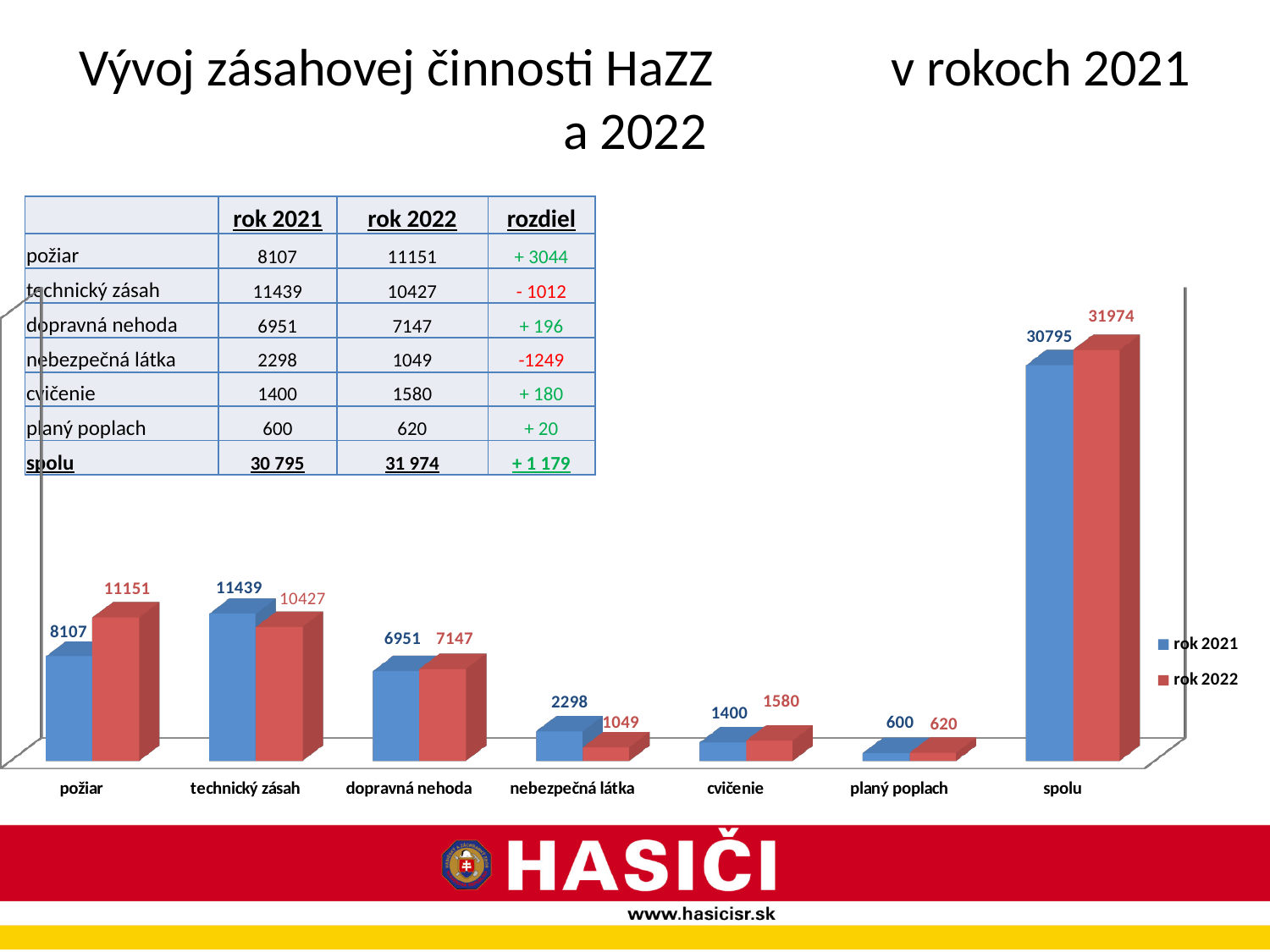
How many series does the chart legend list? 2 What is the value for nebezpečná látka in the rok 2022 series? 1049 What is the value for technický zásah in the rok 2021 series? 11439 What kind of chart is shown on the slide? bar chart What is the value for požiar in the rok 2022 series? 11151 What is the difference between the rok 2022 and rok 2021 values for požiar? 3044 What is the value for spolu in the rok 2022 series? 31974 Excluding the spolu total, which category has the highest value in the rok 2021 series? technický zásah Which category has the lowest value in the rok 2022 series? planý poplach How many categories are shown on the x axis of the chart? 7 Which is larger for technický zásah: the rok 2021 value or the rok 2022 value? rok 2021 What is the value for cvičenie in the rok 2021 series? 1400